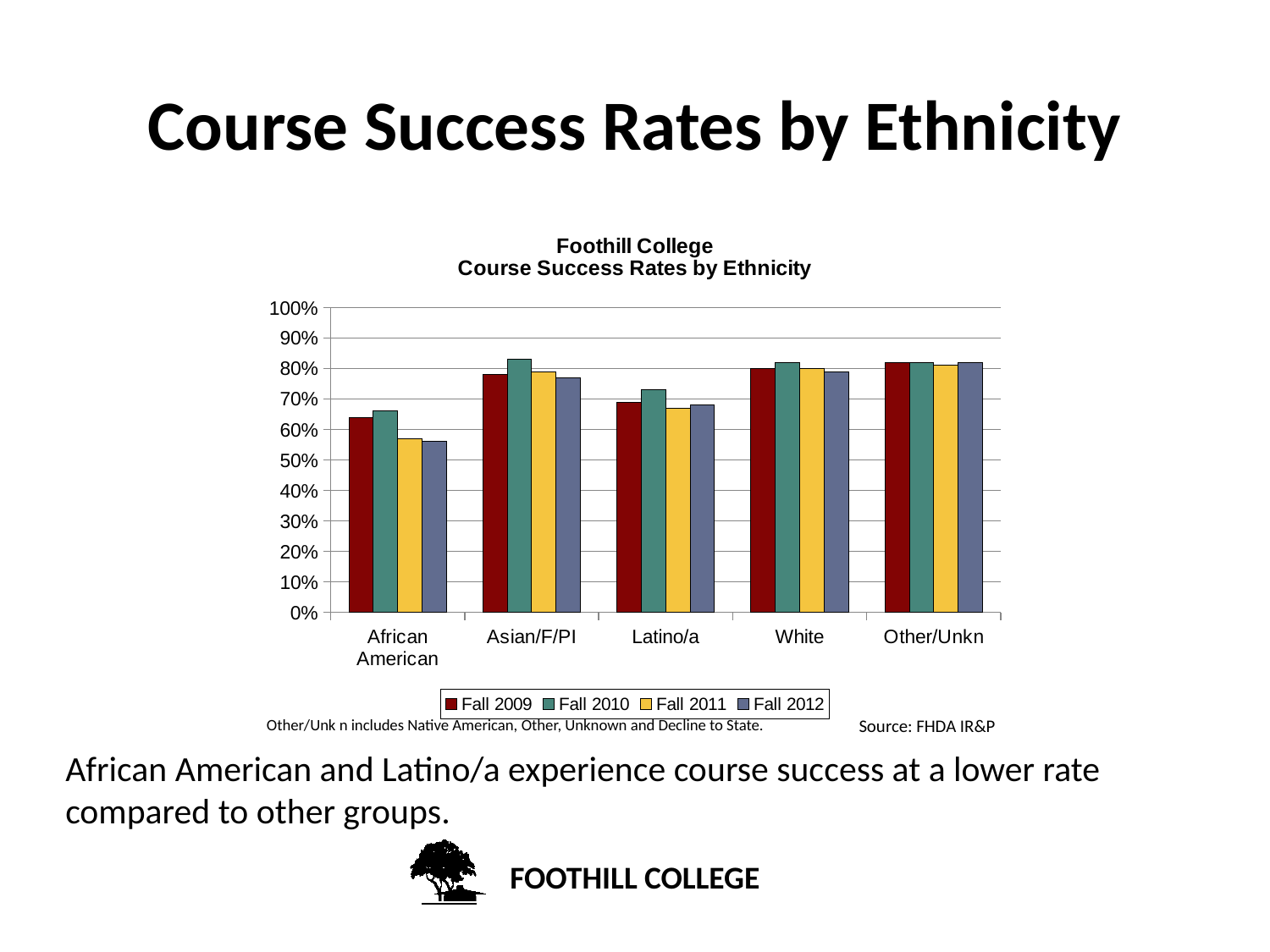
For African American, which is larger: the Fall 2010 value or the Fall 2011 value? Fall 2010 Which ethnicity group has the lowest Fall 2009 course success rate? African American Is the Fall 2012 value for African American greater or less than 60%? less For Fall 2010, which is larger: the value for Asian/F/PI or the value for Latino/a? Asian/F/PI How many series does the legend list? 4 Which ethnicity group has the lowest Fall 2012 course success rate? African American Is the Fall 2009 value for White greater or less than 70%? greater Is the Fall 2010 value for Latino/a greater or less than 70%? greater What kind of chart is shown on the slide? bar chart Which series is listed first in the legend? Fall 2009 How many ethnicity categories are shown on the x axis? 5